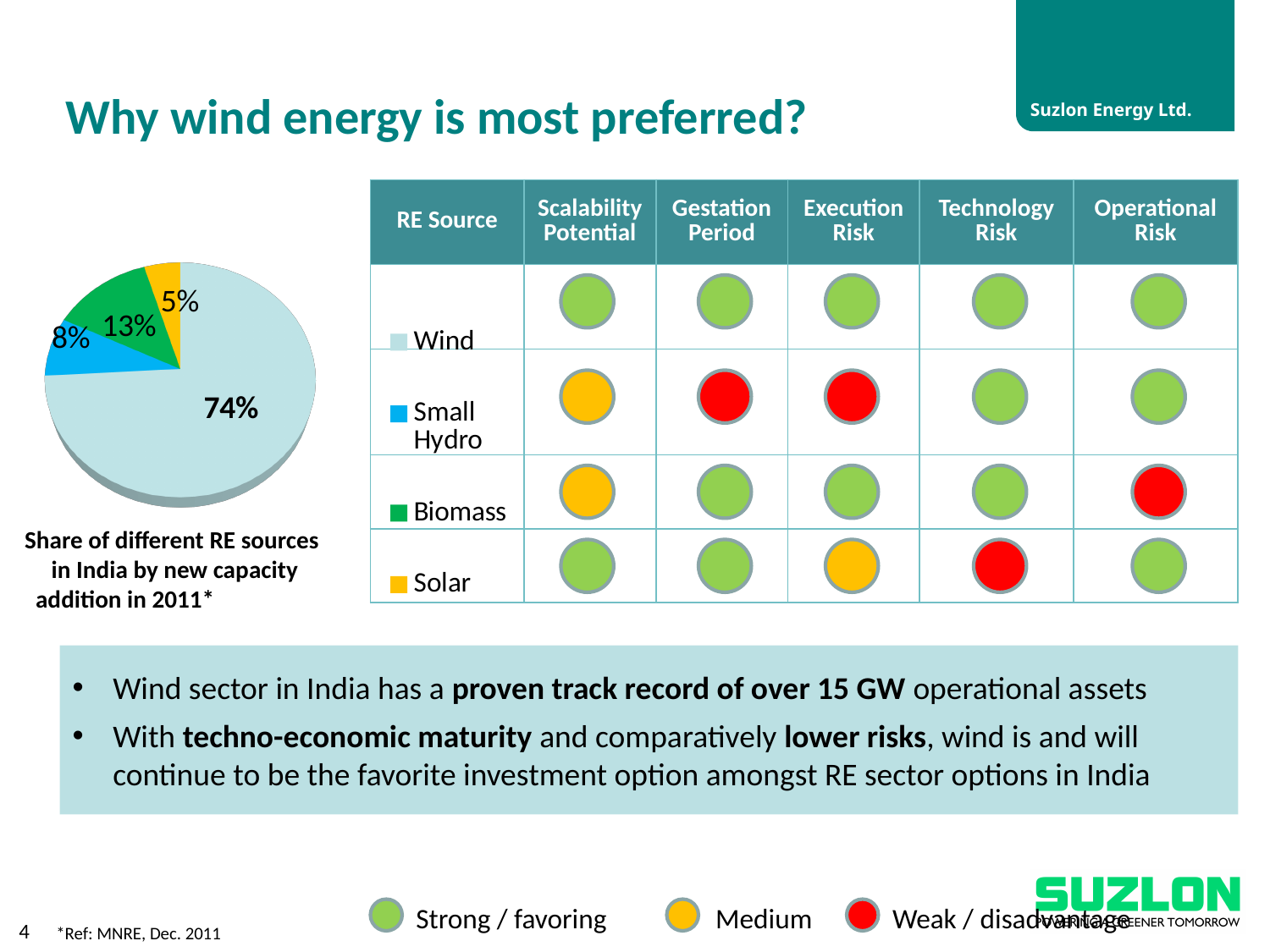
What share does Biomass have in the pie chart? 13% Which has a larger share in the pie chart, Biomass or Small Hydro? Biomass What is the difference in percentage points between the Wind and Biomass shares in the pie chart? 61 What share of new capacity addition in 2011 does Wind account for in the pie chart? 74% What share does Small Hydro have in the pie chart? 8% What kind of chart is shown on the left of the slide? pie chart Which RE source has the smallest slice in the pie chart? Solar What colour is the Biomass slice in the pie chart? green What share does Solar have in the pie chart? 5% Which RE source has the largest slice in the pie chart? Wind How many slices does the pie chart have? 4 What is the combined share of Small Hydro and Solar in the pie chart? 13%